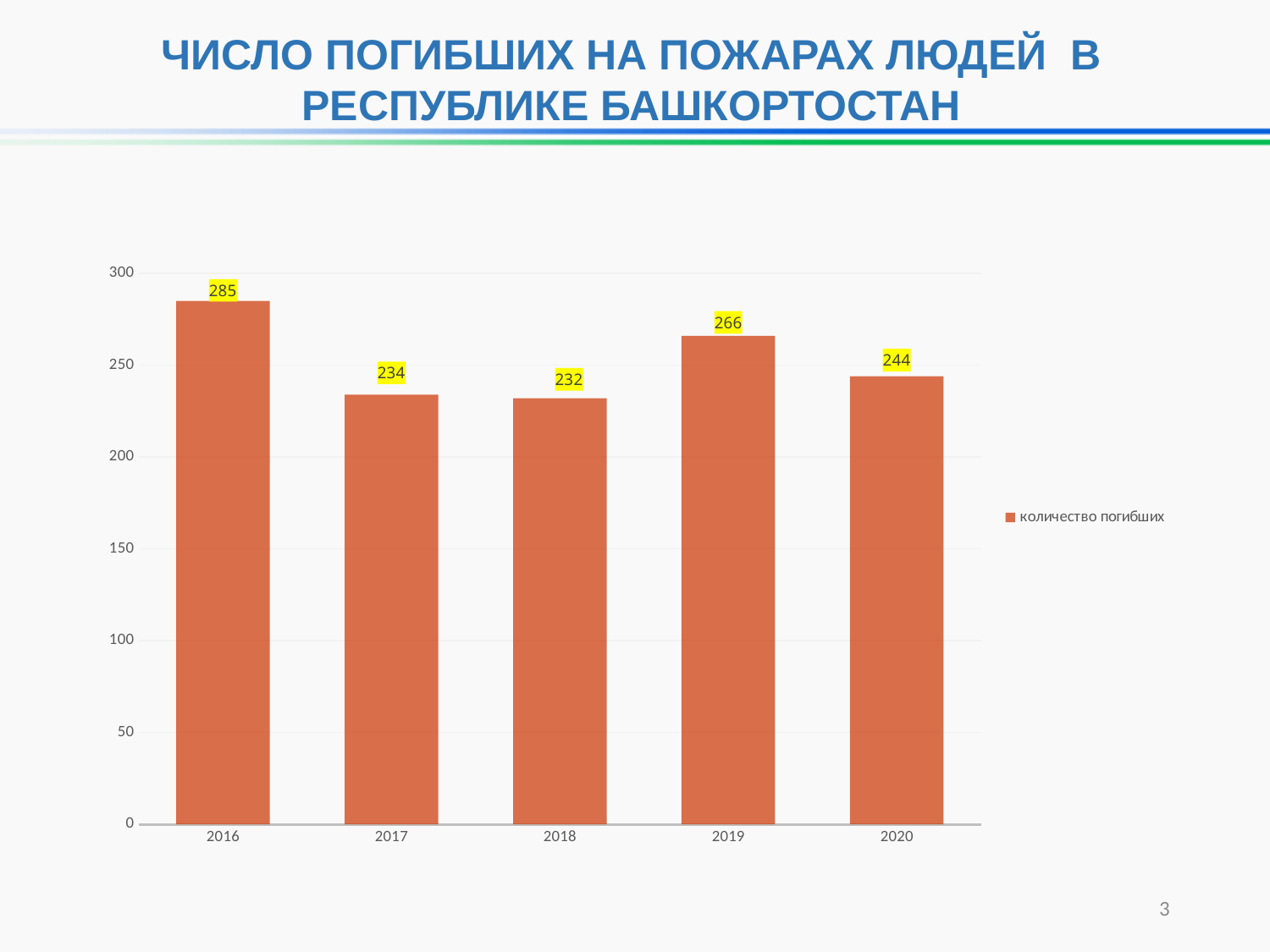
What is the value for 2018? 232 What is the difference between the values for 2019 and 2020? 22 What is the value for 2016? 285 What is the difference between the values for 2016 and 2017? 51 What kind of chart is shown on the slide? bar chart Is the value for 2017 greater or less than 250? less Which year has the lowest value? 2018 How many years are shown on the x axis? 5 Which is larger, the value for 2019 or the value for 2020? 2019 What is the value for 2020? 244 Which year has the highest value? 2016 What series name does the legend list? количество погибших